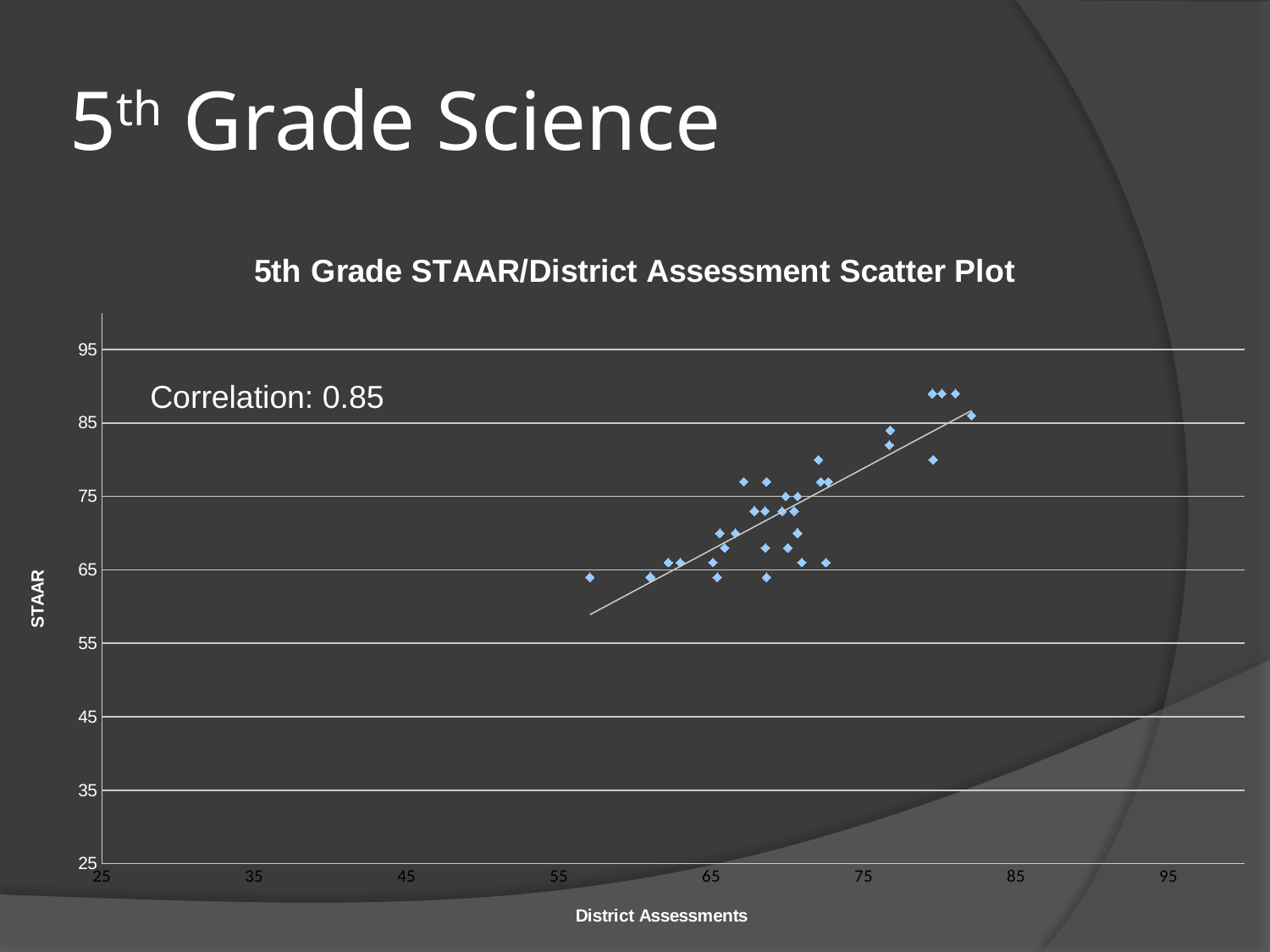
Are any plotted points below 35 on the STAAR axis? No Is the highest STAAR value plotted greater or less than 95? less As District Assessment scores increase along the x axis, do STAAR scores generally rise or fall? Rise Is the lowest STAAR value plotted greater or less than 55? greater What kind of chart is shown on the slide? Scatter plot What is the title of the chart? 5th Grade STAAR/District Assessment Scatter Plot What correlation value is printed on the chart? 0.85